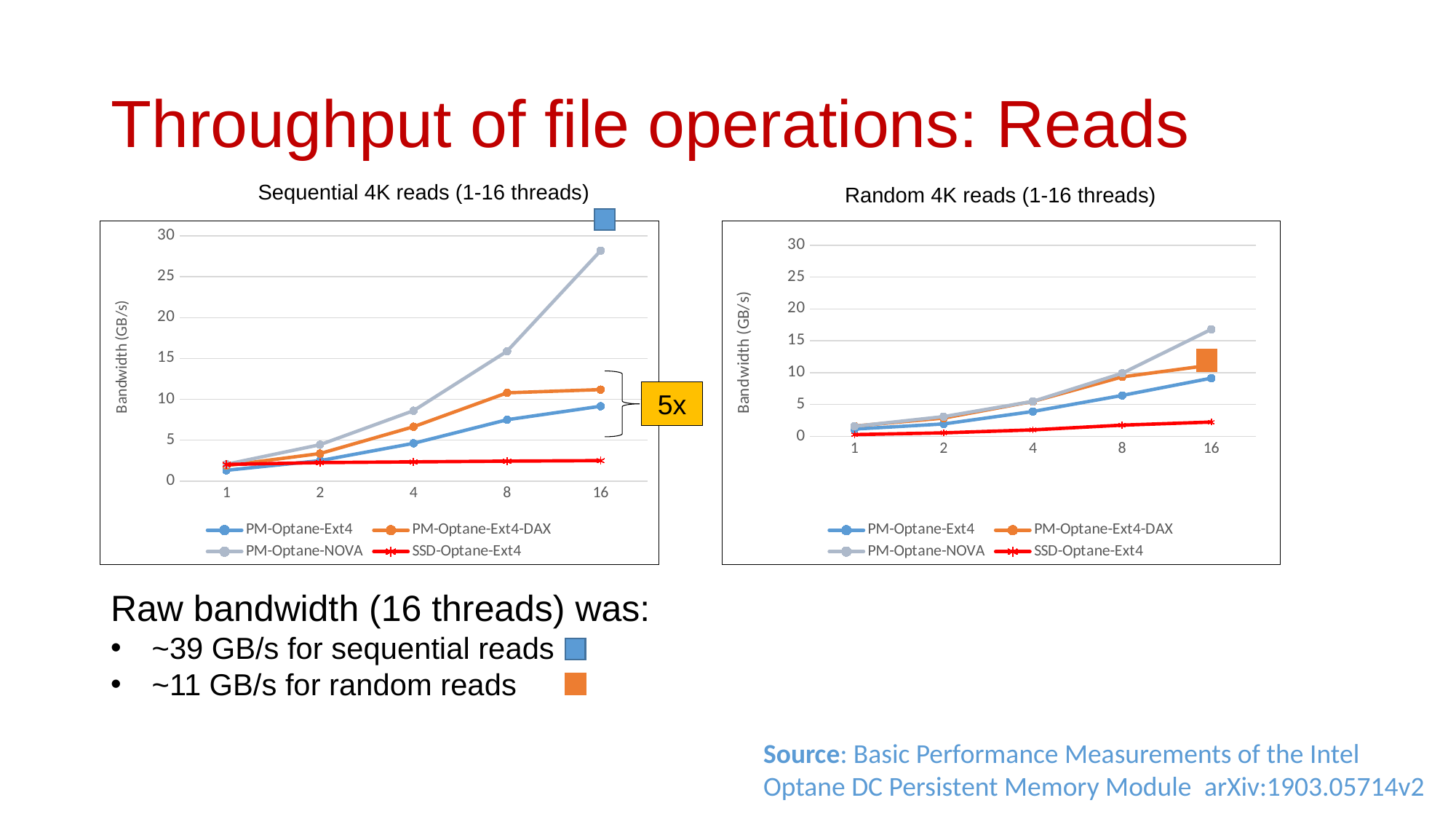
In the 'Sequential 4K reads (1-16 threads)' chart, which series has the lowest bandwidth at 16 threads? SSD-Optane-Ext4 What kind of chart is the 'Sequential 4K reads (1-16 threads)' chart? line chart In the 'Random 4K reads (1-16 threads)' chart, is the PM-Optane-NOVA value at 16 threads greater or less than 15? greater How many thread-count points are plotted along the x axis of the 'Sequential 4K reads (1-16 threads)' chart? 5 In the 'Sequential 4K reads (1-16 threads)' chart, is the PM-Optane-NOVA value at 16 threads greater or less than 25? greater What is the y-axis label on the 'Random 4K reads (1-16 threads)' chart? Bandwidth (GB/s) In the 'Random 4K reads (1-16 threads)' chart, which series has the lowest bandwidth at 16 threads? SSD-Optane-Ext4 In the 'Sequential 4K reads (1-16 threads)' chart, which series has the highest bandwidth at 16 threads? PM-Optane-NOVA How many series does the legend of the 'Random 4K reads (1-16 threads)' chart list? 4 In the 'Random 4K reads (1-16 threads)' chart, is the SSD-Optane-Ext4 value at 16 threads greater or less than 5? less In the 'Sequential 4K reads (1-16 threads)' chart, which is larger at 16 threads: PM-Optane-Ext4-DAX or PM-Optane-Ext4? PM-Optane-Ext4-DAX In the 'Sequential 4K reads (1-16 threads)' chart, does the PM-Optane-NOVA bandwidth rise or fall as the thread count increases from 1 to 16? rise